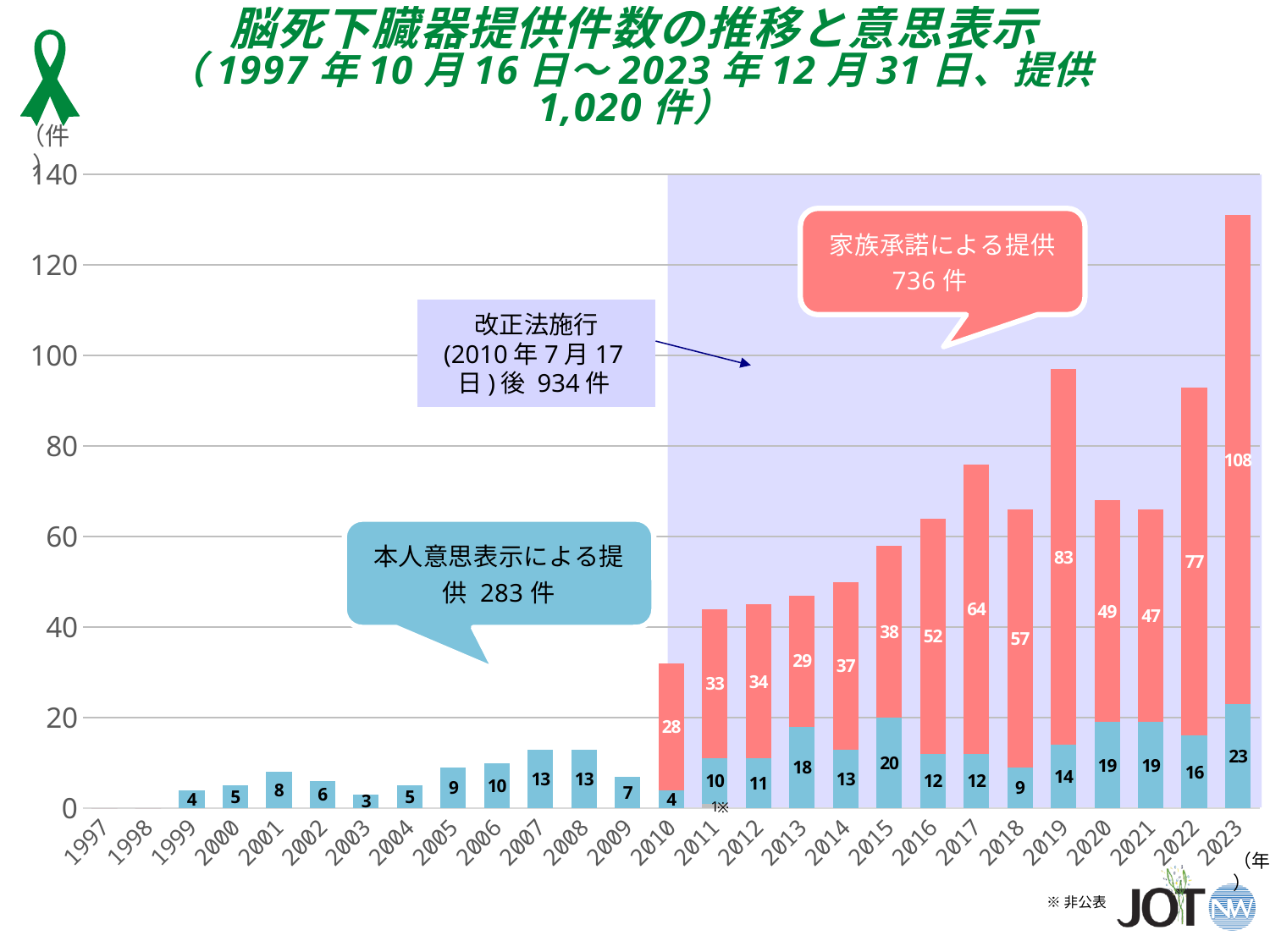
What kind of chart is shown on the slide? stacked bar chart Which is larger, the blue segment for 2013 or the blue segment for 2014? 2013 Which year has the highest value for the red (upper) segment? 2023 What is the value of the red segment for 2019? 83 Is the total bar height for 2019 greater or less than 80? greater Among the years with a printed blue-segment label, which year has the lowest blue value? 2003 What is the value of the blue (lower) segment for 2015? 20 What is the value of the red (upper) segment for 2023? 108 What is the difference between the red segment values for 2022 and 2021? 30 How many years are shown on the x axis? 27 What is the total of the stacked bar for 2023? 131 Does the red segment value rise or fall from 2015 to 2017? rise